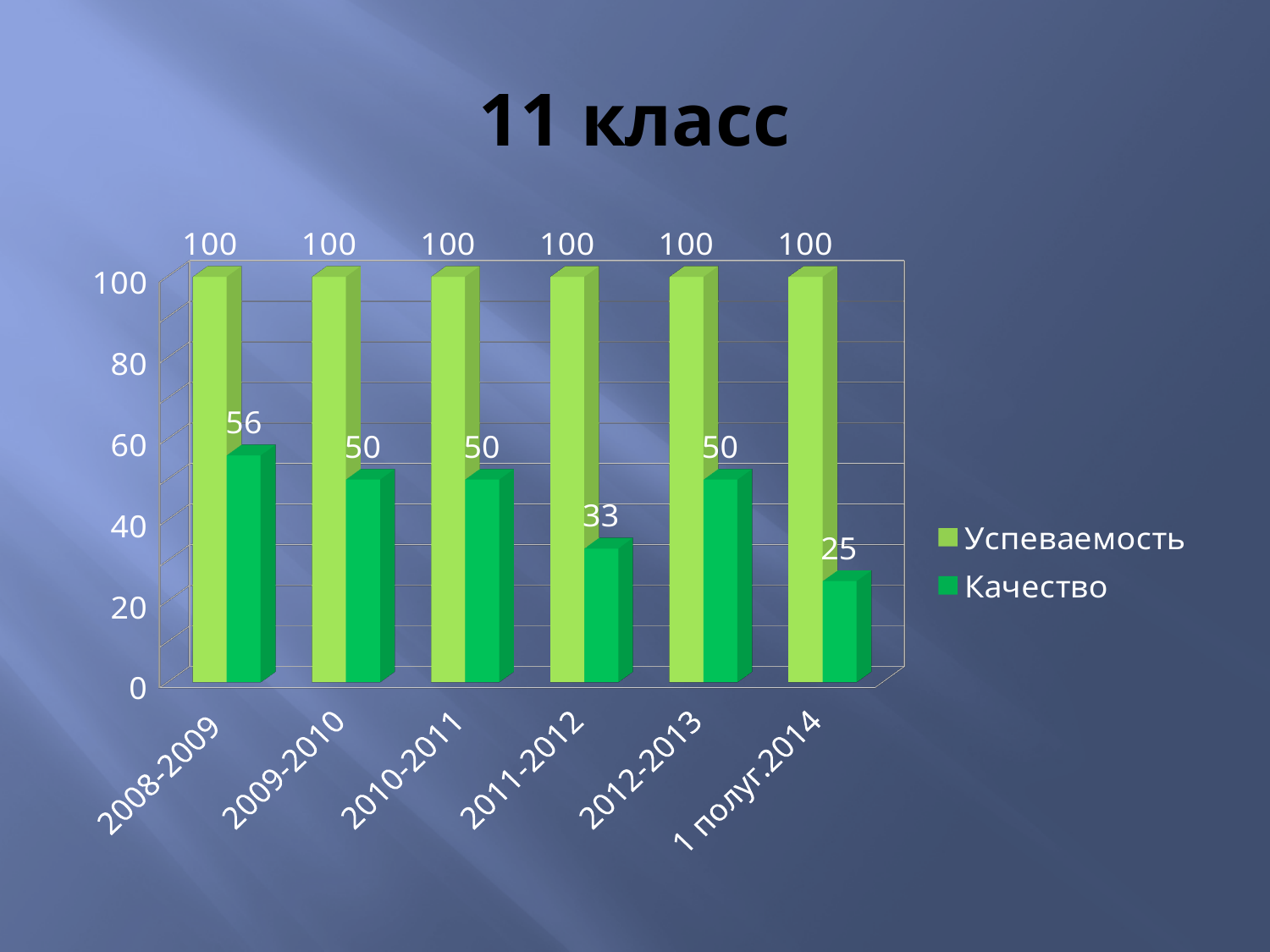
What is the value of Успеваемость for 2012-2013? 100 Which is larger, the Качество value for 2012-2013 or for 2011-2012? 2012-2013 How many categories are shown on the x axis? 6 Which category has the highest Качество value? 2008-2009 What is the value of Качество for 2011-2012? 33 Which category has the lowest Качество value? 1 полуг.2014 What is the difference between the Качество values for 2008-2009 and 1 полуг.2014? 31 What is the difference between Успеваемость and Качество for 2011-2012? 67 What is the value of Качество for 2008-2009? 56 What is the value of Качество for 1 полуг.2014? 25 What kind of chart is shown on the slide? Bar chart How many series does the legend list? 2